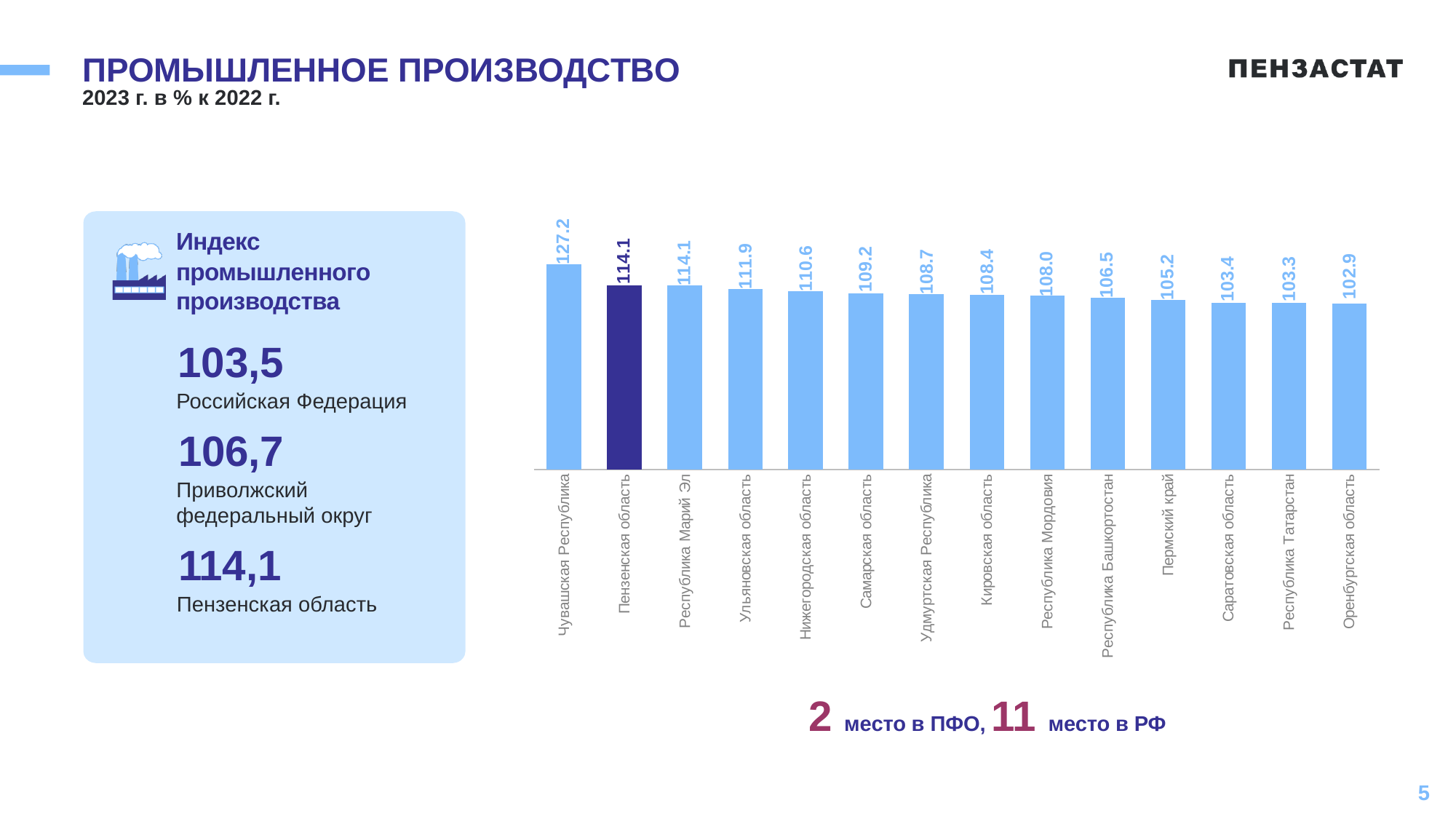
What is the difference between the values for Чувашская Республика and Пензенская область? 13.1 What is the value for Пензенская область in the bar chart? 114.1 Which region has the highest value in the chart? Чувашская Республика What is the value for Чувашская Республика? 127.2 What is the value for Республика Башкортостан? 106.5 Do the values rise or fall from left to right along the x axis? fall What is the value for Нижегородская область? 110.6 Which region's bar is highlighted in dark blue? Пензенская область Which has a larger value, Самарская область or Кировская область? Самарская область What kind of chart is shown on the slide? bar chart How many regions are plotted in the bar chart? 14 Which region has the lowest value in the chart? Оренбургская область